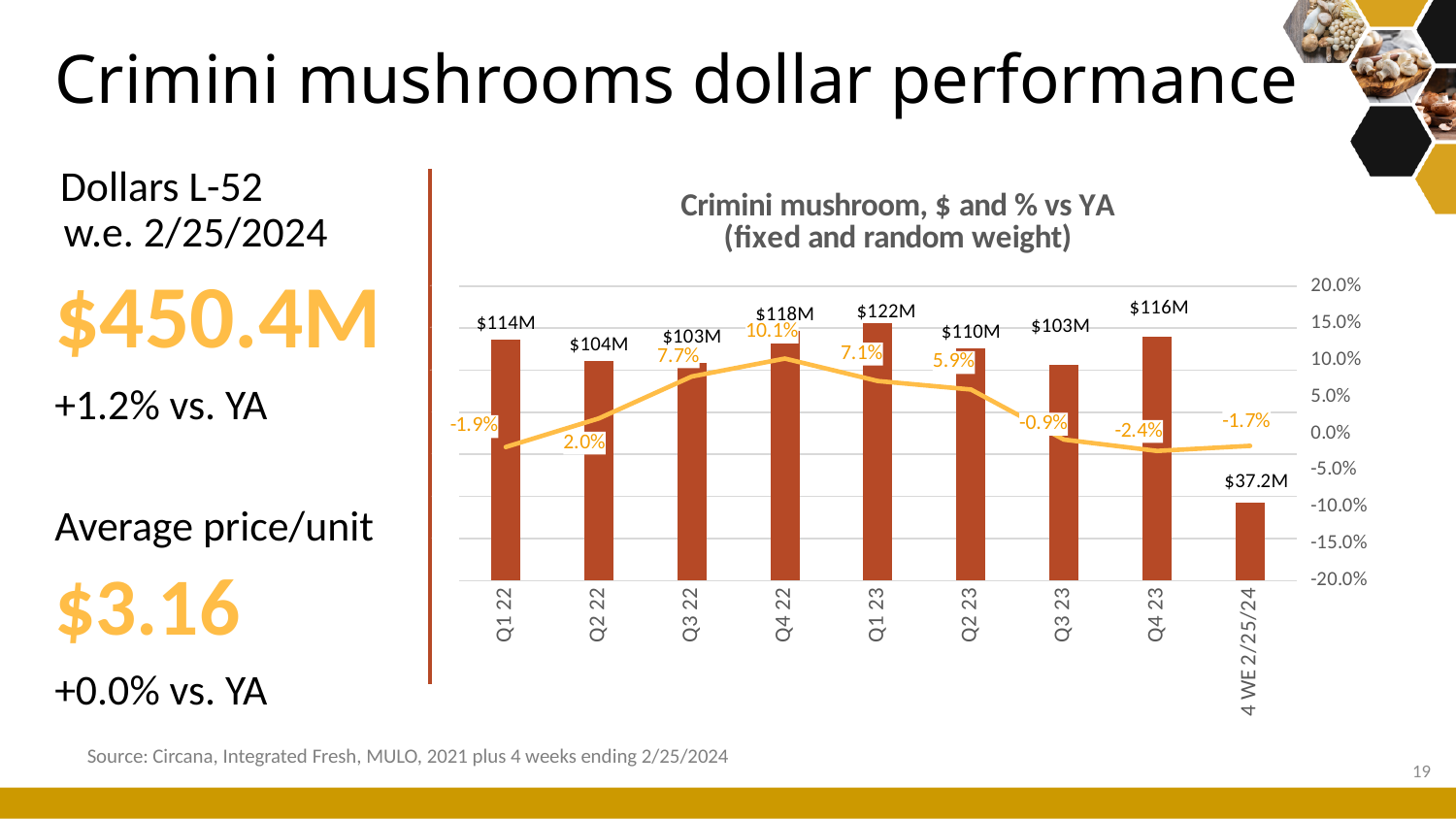
What is the % vs YA value shown for Q4 22? 10.1% What is the title of the chart? Crimini mushroom, $ and % vs YA (fixed and random weight) Which has a higher dollar value, Q4 22 or Q4 23? Q4 22 Which period has the lowest dollar value? 4 WE 2/25/24 What is the dollar value shown for the 4 WE 2/25/24 period? $37.2M Which quarter has the highest dollar value? Q1 23 What is the dollar value shown for Q2 22? $104M What is the % vs YA value shown for Q4 23? -2.4% What is the dollar value shown for Q1 23? $122M Does the % vs YA line rise or fall from Q4 22 to Q4 23? Fall How many periods are shown on the x axis? 9 What is the difference in dollar value between Q1 23 and Q2 23? $12M